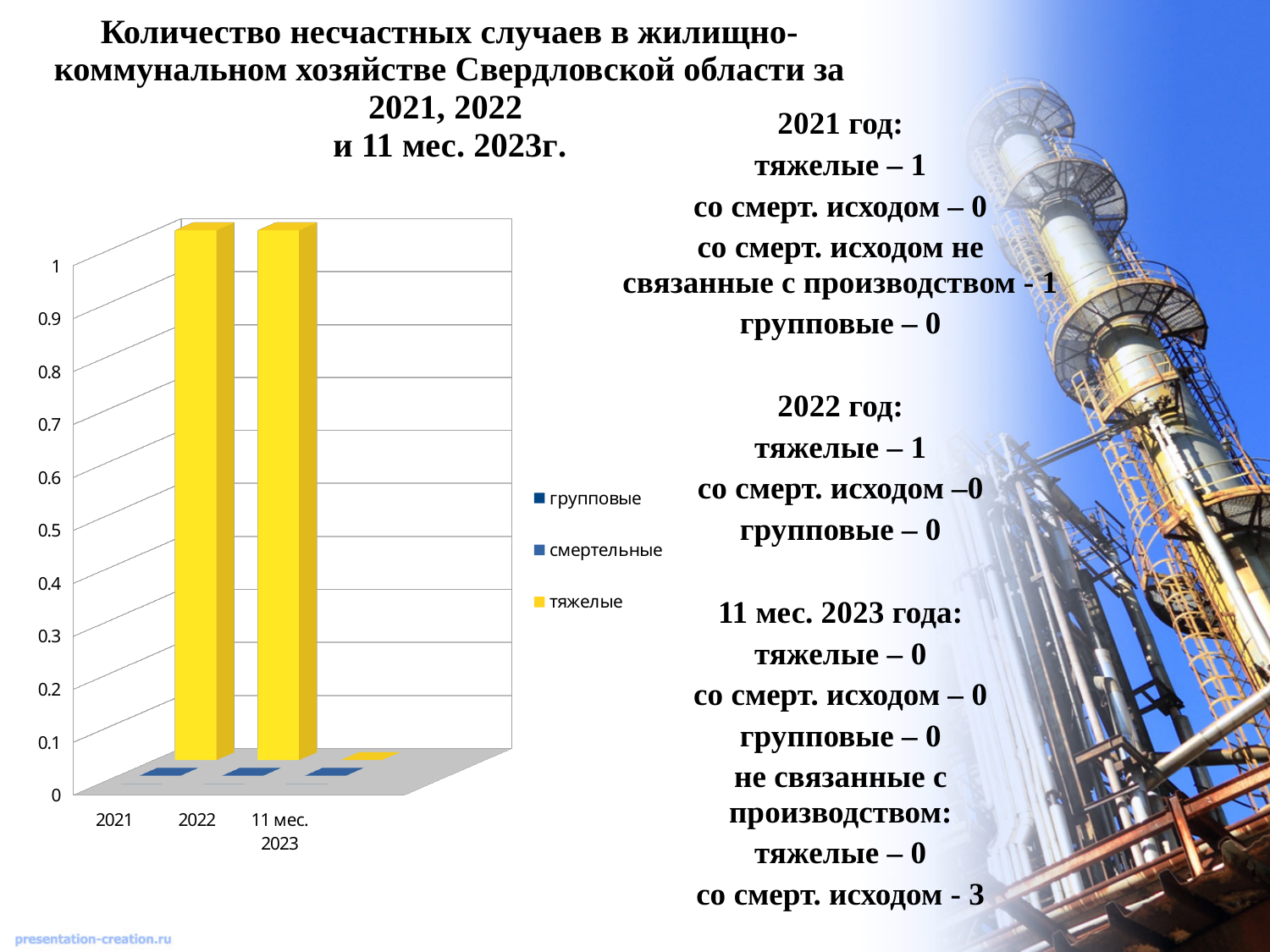
What is the difference between the тяжелые values for 2022 and 11 мес. 2023? 1 Which category has the lowest value for the тяжелые series? 11 мес. 2023 How many categories are shown on the x axis of the chart? 3 Which is larger: the тяжелые value for 2021 or for 11 мес. 2023? 2021 What kind of chart is shown on the slide? bar chart How many series does the chart legend list? 3 What is the value of the тяжелые series for 11 мес. 2023? 0 Is the value of the тяжелые series for 11 мес. 2023 greater or less than 0.5? less What is the value of the тяжелые series for 2021? 1 What is the value of the тяжелые series for 2022? 1 Which series is shown in yellow in the chart? тяжелые Is the value of the тяжелые series for 2022 greater or less than 0.5? greater